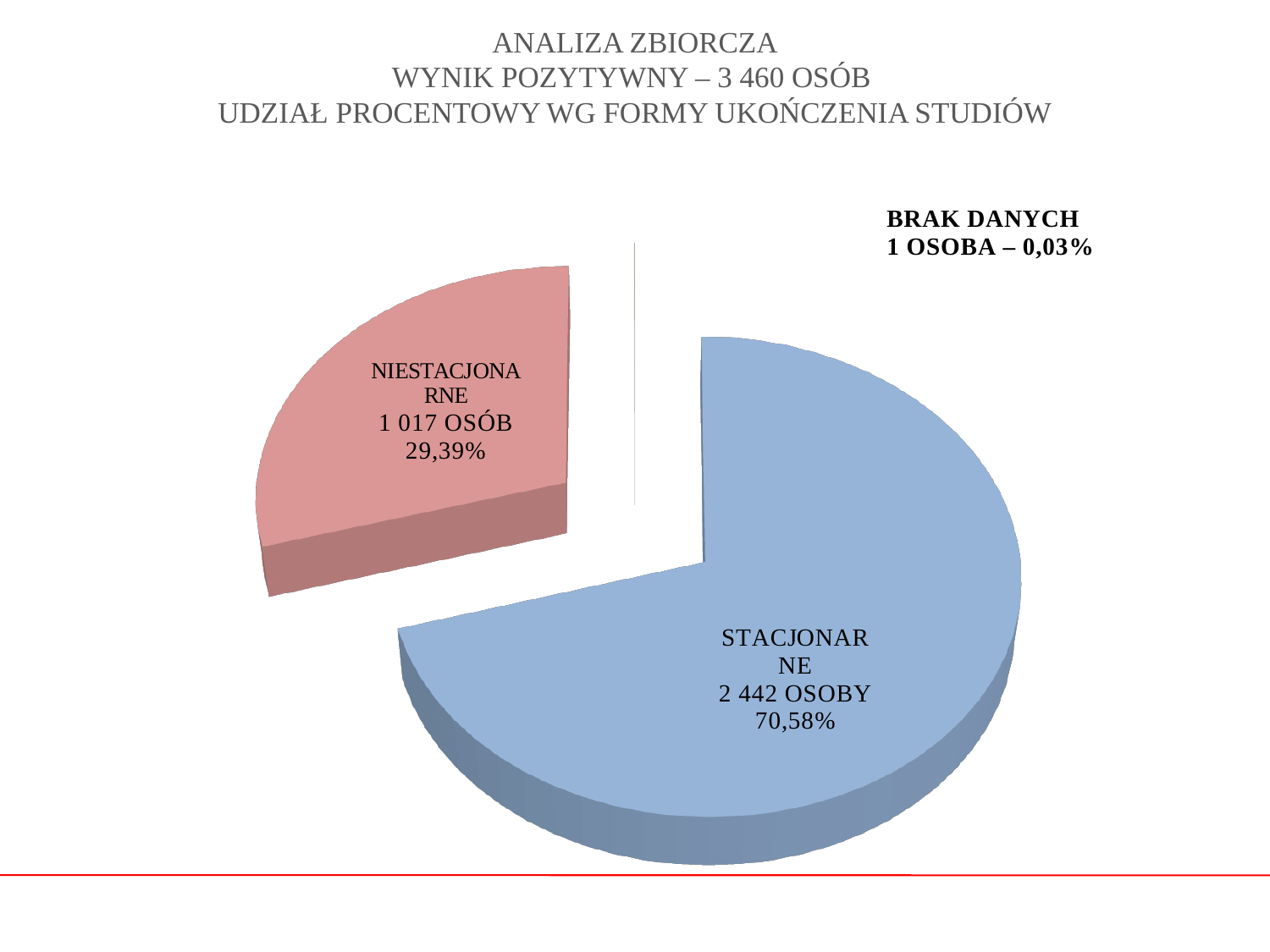
How many people are in the STACJONARNE category? 2 442 What percentage share does the STACJONARNE slice have? 70,58% Which category has the smallest share of the pie? BRAK DANYCH How many people are in the BRAK DANYCH category? 1 Which category has the largest share of the pie? STACJONARNE How many slices does the pie chart have? 3 What percentage share does the BRAK DANYCH slice have? 0,03% What is the difference in number of people between STACJONARNE and NIESTACJONARNE? 1 425 What percentage share does the NIESTACJONARNE slice have? 29,39% How many people are in the NIESTACJONARNE category? 1 017 What kind of chart is shown on the slide? Pie chart What total number of people with a positive result is stated in the chart title? 3 460